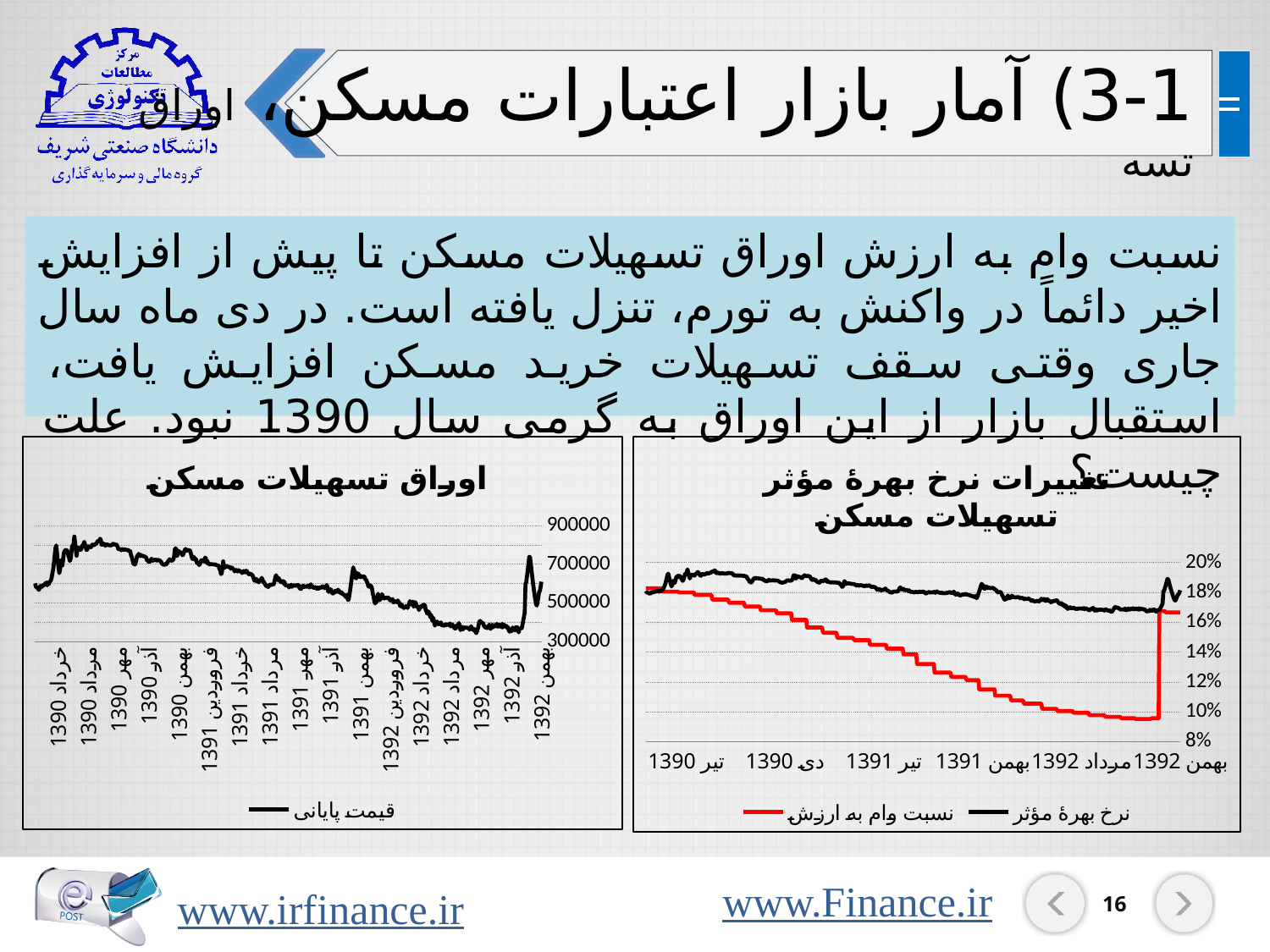
What is the name of the series shown in the left chart ("اوراق تسهیلات مسکن")? قیمت پایانی What kind of chart is the left chart titled "اوراق تسهیلات مسکن"? line chart In the right chart, which series is drawn in red? نسبت وام به ارزش In the right chart, is the value of the black series "نسبت وام به ارزش" at the start of the series (left end) greater or less than 16%? greater What kind of chart is the right chart titled "تغییرات نرخ بهرۀ مؤثر تسهیلات مسکن"? line chart In the left chart, is the peak value of "قیمت پایانی" greater or less than 700000? greater How many series does the legend of the left chart ("اوراق تسهیلات مسکن") list? 1 In the right chart, is the highest value of the black series "نسبت وام به ارزش" greater or less than 20%? less How many series does the legend of the right chart ("تغییرات نرخ بهرۀ مؤثر تسهیلات مسکن") list? 2